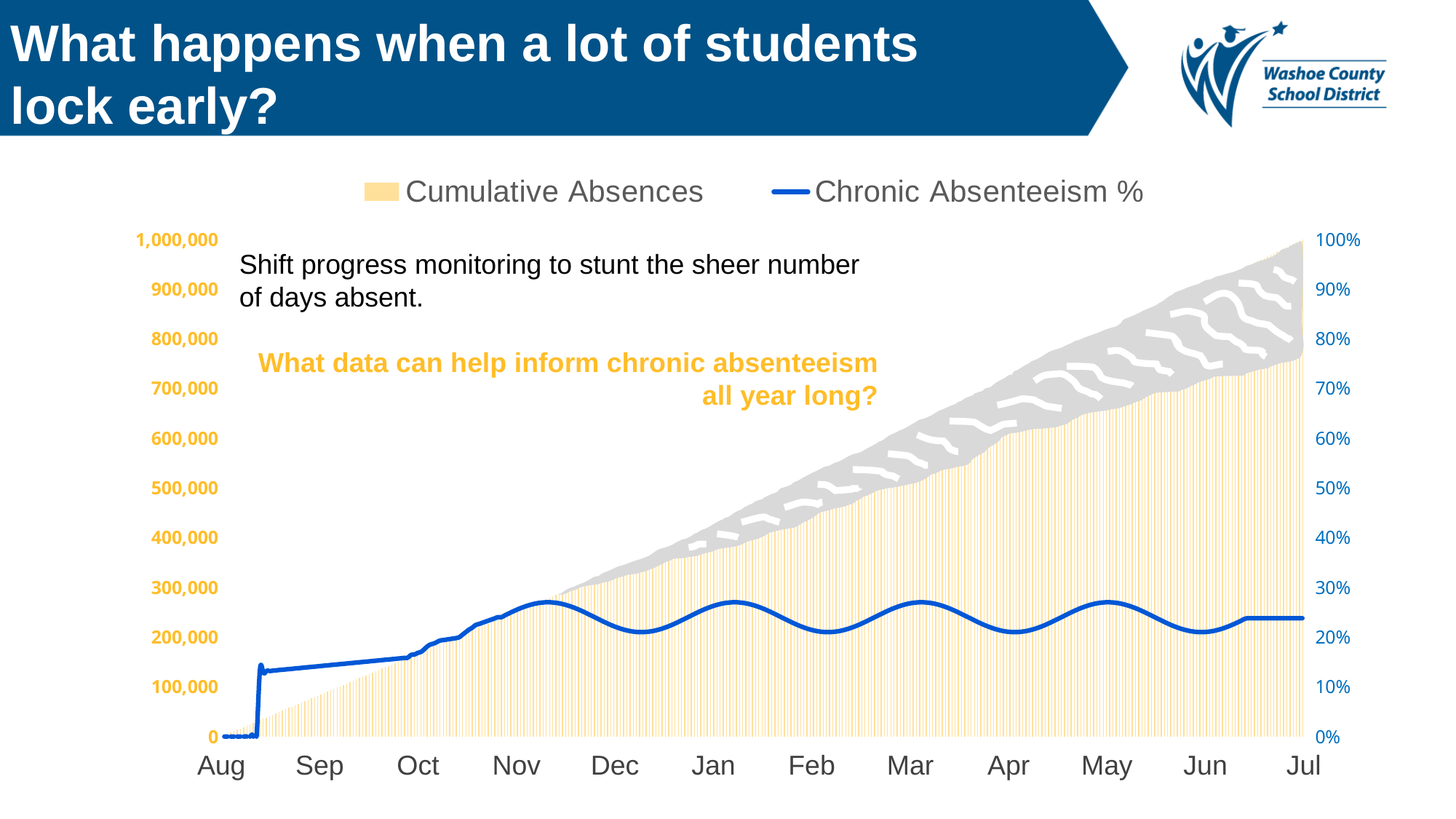
How many series does the chart legend list? 2 Is the Chronic Absenteeism % value at Nov greater or less than 20%? greater Is the Cumulative Absences value at Oct greater or less than 100,000? greater How many month labels are shown along the x axis of the chart? 12 Is the Cumulative Absences value at Jul greater or less than 500,000? greater Which month label appears first on the x axis of the chart? Aug What are the two series named in the chart legend? Cumulative Absences and Chronic Absenteeism % Do the Cumulative Absences values rise or fall from Aug to Jul? Rise What kind of chart is shown on the slide? Combined bar and line chart